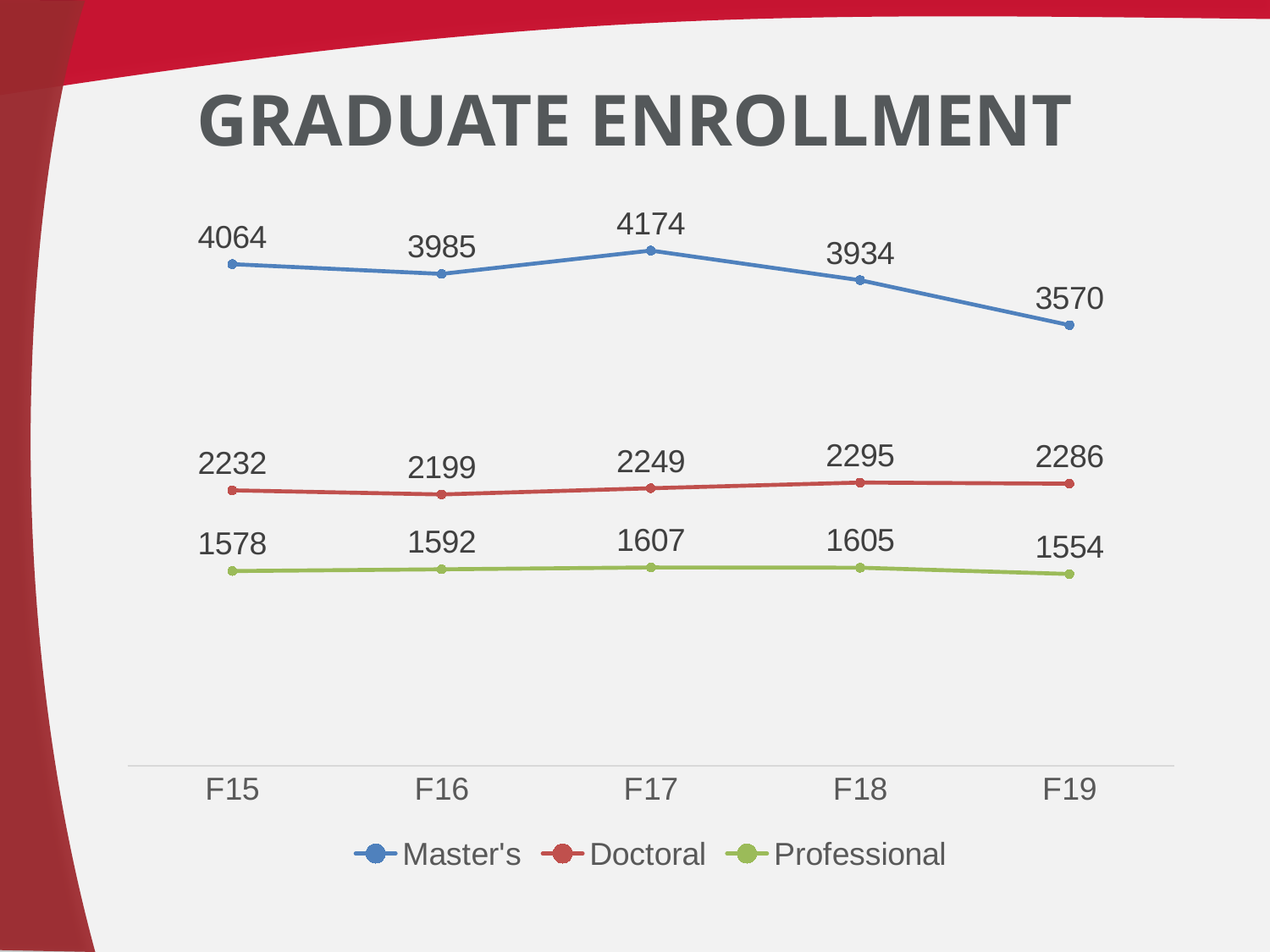
Does Master's enrollment rise or fall from F17 to F19? Fall What is the title of the chart? GRADUATE ENROLLMENT What kind of chart is shown? Line chart How many years are shown on the x axis? 5 What is the Master's enrollment in F17? 4174 What is the Doctoral enrollment in F16? 2199 How many series does the legend list? 3 In which year is Master's enrollment highest? F17 Which is larger, Doctoral enrollment in F18 or in F19? F18 What is the Professional enrollment in F19? 1554 What is the difference between Master's enrollment in F15 and F19? 494 In which year is Professional enrollment lowest? F19